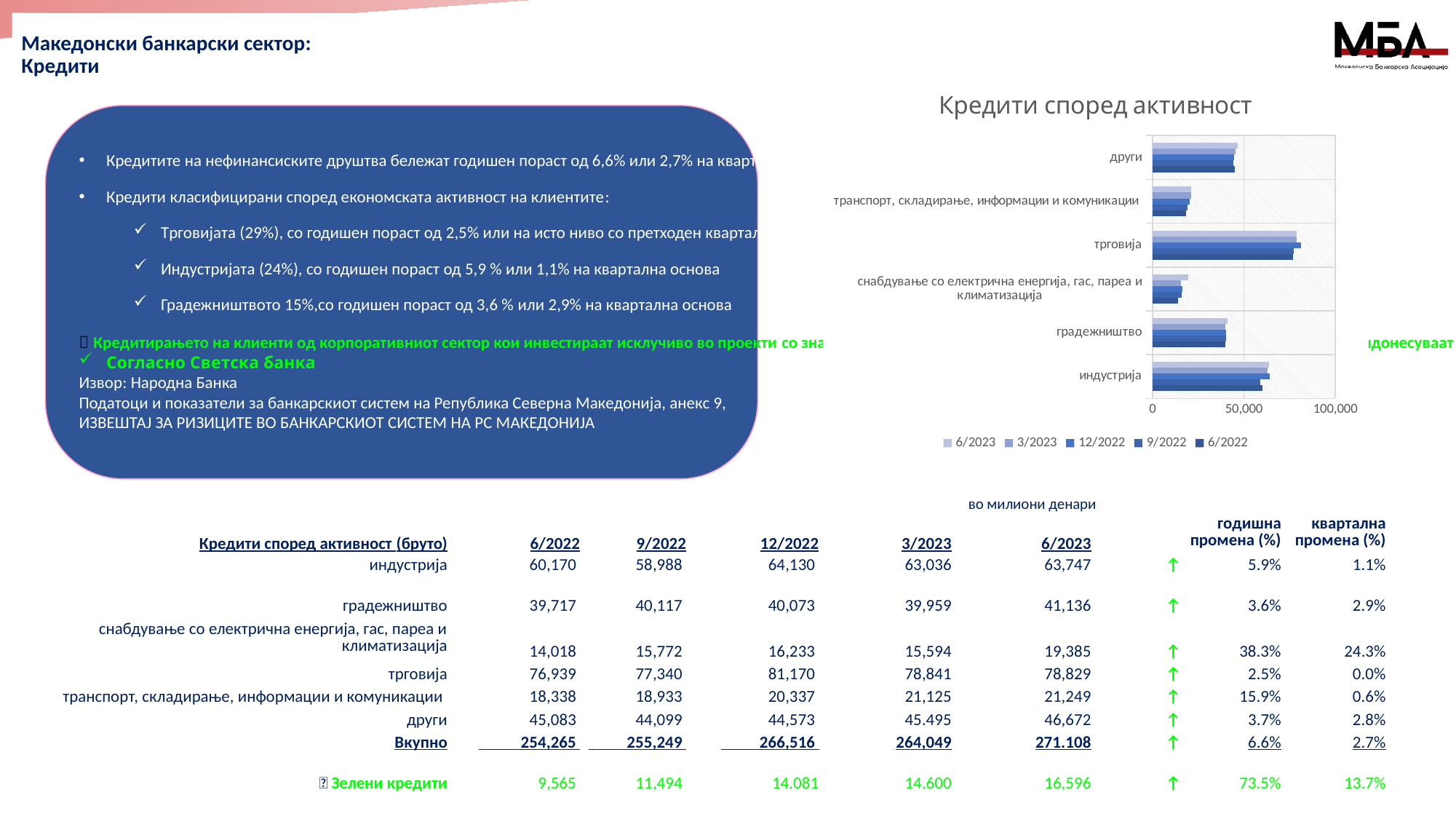
What is the value for трговија in the 6/2023 series, as printed in the table below the chart? 78,829 How many series does the legend of the "Кредити според активност" chart list? 5 On the "Кредити според активност" chart, which is larger: индустрија or градежништво? индустрија What is the first entry in the legend of the "Кредити според активност" chart? 6/2023 Which category has the longest bars on the "Кредити според активност" chart? трговија What kind of chart is shown under the title "Кредити според активност"? bar chart Which category has the shortest bars on the "Кредити според активност" chart? снабдување со електрична енергија, гас, пареа и климатизација How many categories are shown on the "Кредити според активност" chart? 6 Using the printed 6/2023 values, what is the difference between трговија and индустрија? 15,082 On the "Кредити според активност" chart, is the value for трговија greater or less than 50,000? greater What is the value for индустрија in the 6/2022 series, as printed in the table below the chart? 60,170 On the "Кредити според активност" chart, is the value for градежништво greater or less than 50,000? less